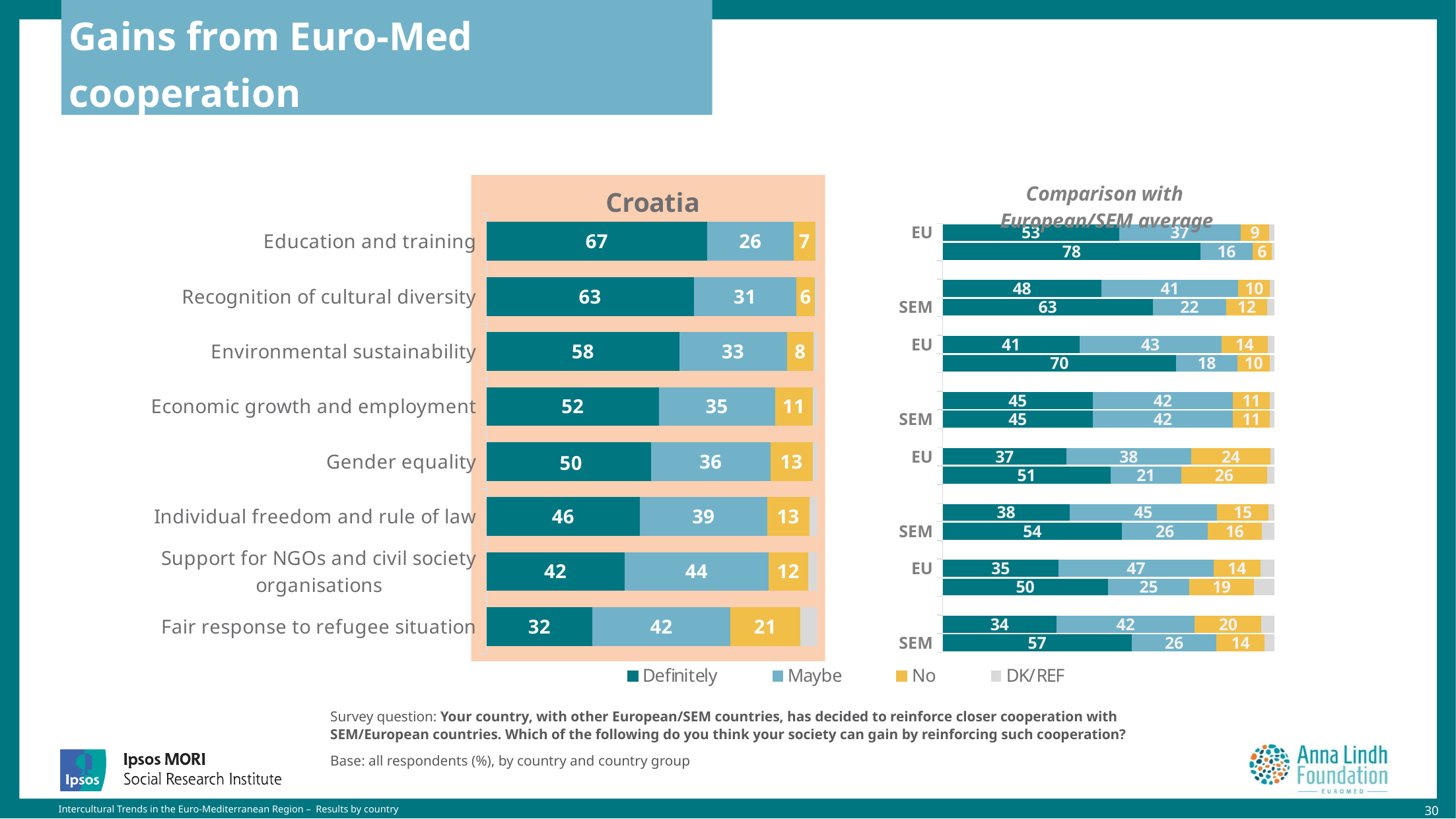
In the Croatia chart, what is the difference between the 'Definitely' values for Recognition of cultural diversity and Gender equality? 13 In the Croatia chart, is the 'Definitely' value larger for Environmental sustainability or for Economic growth and employment? Environmental sustainability In the Croatia chart, what is the 'No' value for Fair response to refugee situation? 21 In the Croatia chart, what is the 'Maybe' value for Support for NGOs and civil society organisations? 44 What type of chart is the Croatia chart? Stacked bar chart In the Croatia chart, which category has the highest 'Definitely' value? Education and training How many series does the legend list? 4 In the Croatia chart, what percentage say 'Definitely' for Education and training? 67 How many categories are shown in the Croatia chart? 8 In the Croatia chart, which category has the lowest 'Definitely' value? Fair response to refugee situation In the comparison chart, what is the 'Definitely' value for the SEM bar in the top (Education and training) row? 78 In the comparison chart, what is the 'No' value for the EU bar in the Gender equality row? 24